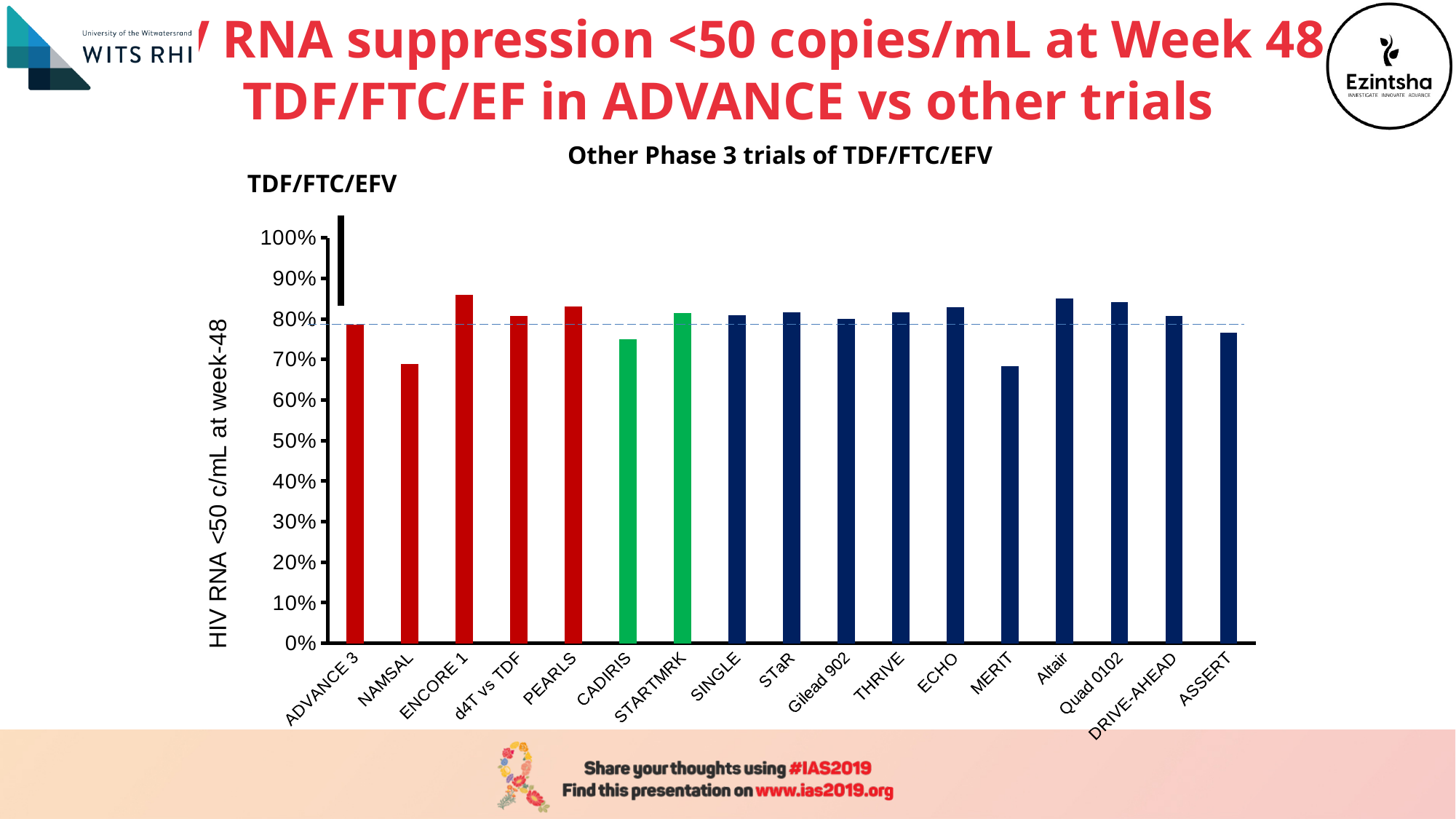
How many bars on the chart are coloured green? 2 What kind of chart is shown on the slide? bar chart What is the label on the vertical axis of the chart? HIV RNA <50 c/mL at week-48 Which has the higher value, MERIT or Altair? Altair How many trials (bars) are plotted on the chart? 17 Which has the higher value, CADIRIS or STARTMRK? STARTMRK Is the value for CADIRIS greater or less than 80%? less Which has the higher value, ENCORE 1 or NAMSAL? ENCORE 1 Is the value for ENCORE 1 greater or less than 80%? greater Is the value for NAMSAL greater or less than 80%? less